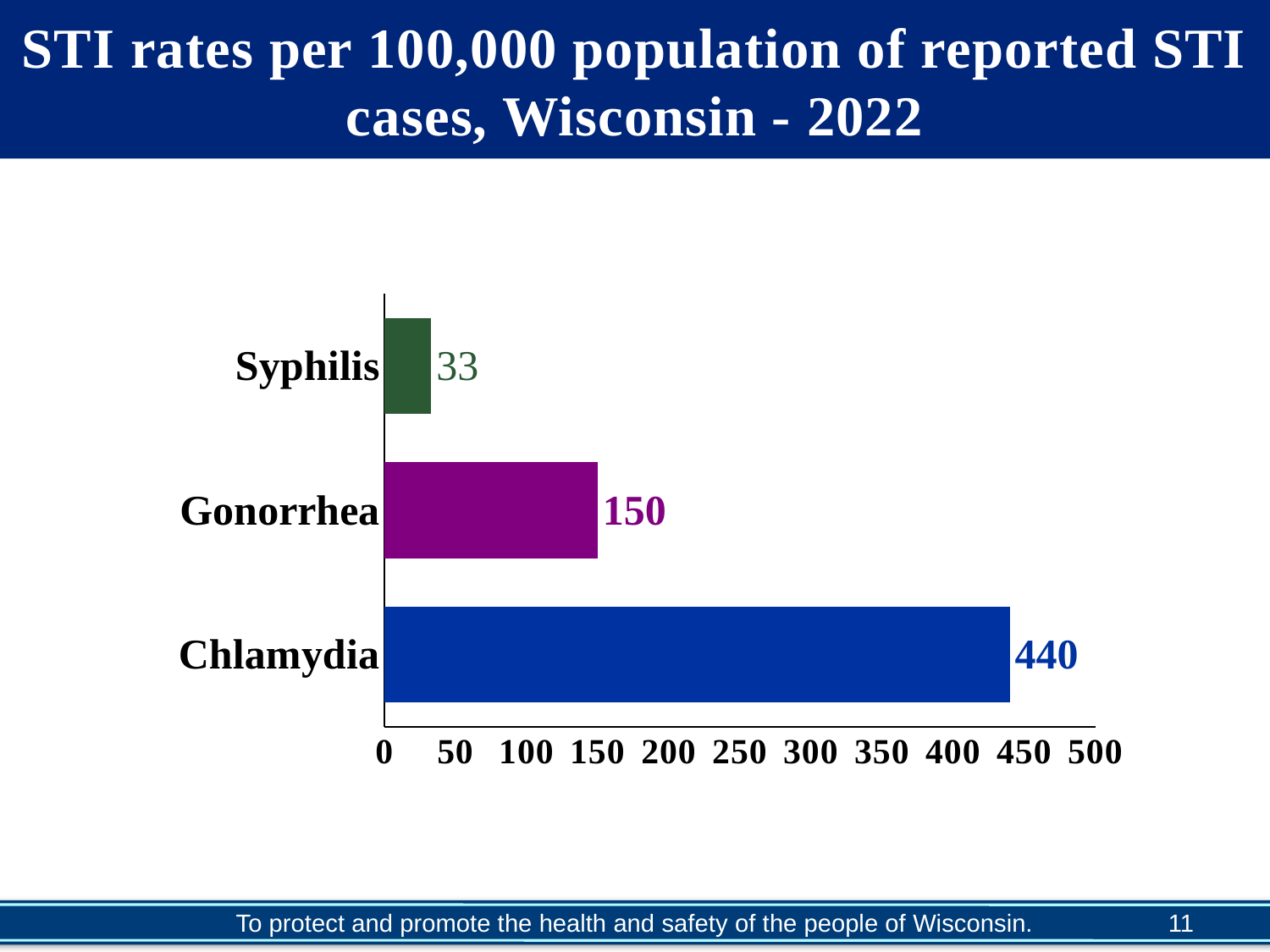
What is the difference between the Chlamydia rate and the Gonorrhea rate? 290 What is the STI rate per 100,000 population for Gonorrhea? 150 What is the title of the chart on the slide? STI rates per 100,000 population of reported STI cases, Wisconsin - 2022 What is the STI rate per 100,000 population for Syphilis? 33 What kind of chart is shown on the slide? Bar chart What is the STI rate per 100,000 population for Chlamydia? 440 Which has a higher rate, Gonorrhea or Syphilis? Gonorrhea Which STI has the lowest rate per 100,000 population? Syphilis What is the difference between the Gonorrhea rate and the Syphilis rate? 117 Is the value for Chlamydia greater or less than 400? greater How many STI categories are shown in the chart? 3 Which STI has the highest rate per 100,000 population? Chlamydia